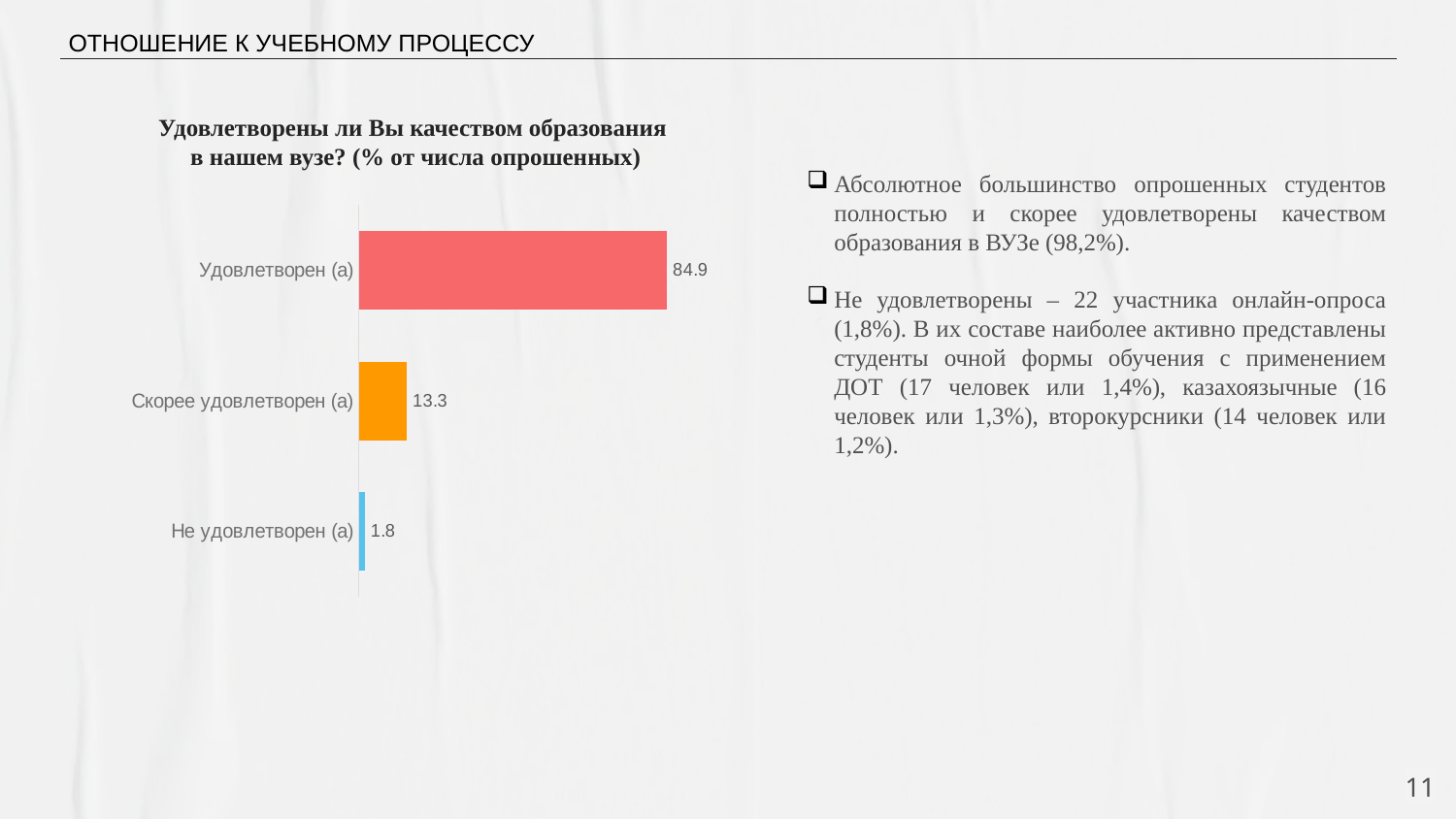
Which is larger, the value for Скорее удовлетворен (а) or the value for Не удовлетворен (а)? Скорее удовлетворен (а) What is the value for Не удовлетворен (а)? 1.8 What is the value for Скорее удовлетворен (а)? 13.3 What is the difference between the values for Удовлетворен (а) and Скорее удовлетворен (а)? 71.6 Which category has the highest value? Удовлетворен (а) What kind of chart is shown on the slide? bar chart What is the difference between the values for Скорее удовлетворен (а) and Не удовлетворен (а)? 11.5 Which category has the lowest value? Не удовлетворен (а) What colour is the bar for Скорее удовлетворен (а)? orange What is the title of the chart? Удовлетворены ли Вы качеством образования в нашем вузе? (% от числа опрошенных) What is the value for Удовлетворен (а)? 84.9 How many categories are shown in the chart? 3